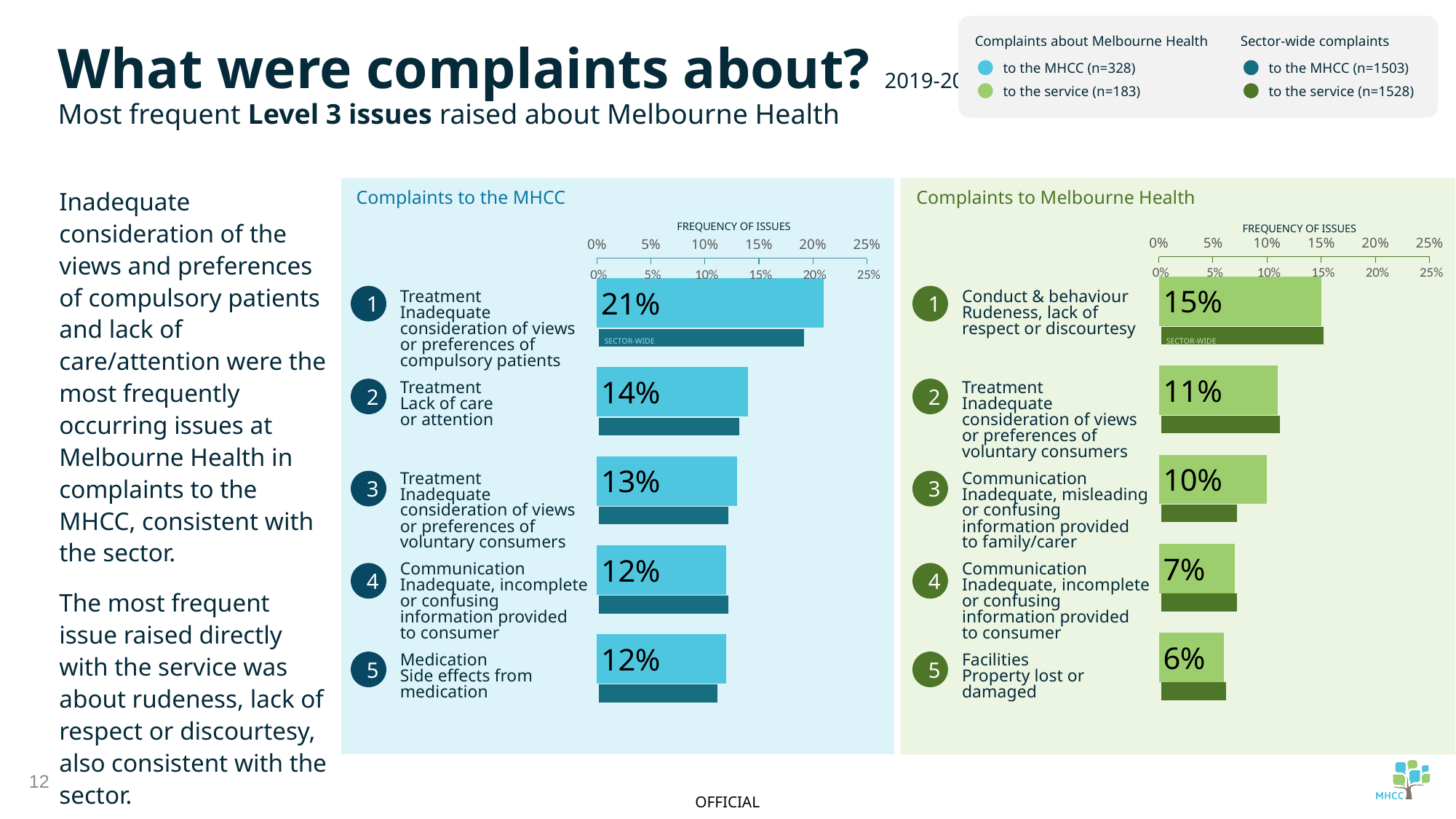
What type of chart is used in the 'Complaints to the MHCC' panel? bar chart Is the frequency for 'Communication – Inadequate, incomplete or confusing information provided to consumer' higher in the 'Complaints to the MHCC' chart or the 'Complaints to Melbourne Health' chart? Complaints to the MHCC In the 'Complaints to the MHCC' chart, what is the difference in frequency between the rank 1 issue (21%) and the rank 2 issue (14%)? 7 percentage points How many issues are ranked in the 'Complaints to Melbourne Health' chart? 5 In the 'Complaints to Melbourne Health' chart, what is the frequency for 'Facilities – Property lost or damaged'? 6% In the 'Complaints to Melbourne Health' chart, which issue has the lowest frequency? Facilities – Property lost or damaged In the 'Complaints to Melbourne Health' chart, what is the frequency for 'Communication – Inadequate, misleading or confusing information provided to family/carer'? 10% In the 'Complaints to the MHCC' chart, do the frequencies rise or fall from rank 1 to rank 5? fall In the 'Complaints to the MHCC' chart, is the sector-wide bar for the rank 1 issue greater or less than 15%? greater In the 'Complaints to Melbourne Health' chart, what is the difference between 'Conduct & behaviour' (15%) and 'Treatment – Inadequate consideration of views or preferences of voluntary consumers' (11%)? 4 percentage points In the 'Complaints to the MHCC' chart, which issue has the highest frequency? Treatment – Inadequate consideration of views or preferences of compulsory patients In the 'Complaints to the MHCC' chart, what is the frequency for 'Treatment – Lack of care or attention'? 14%